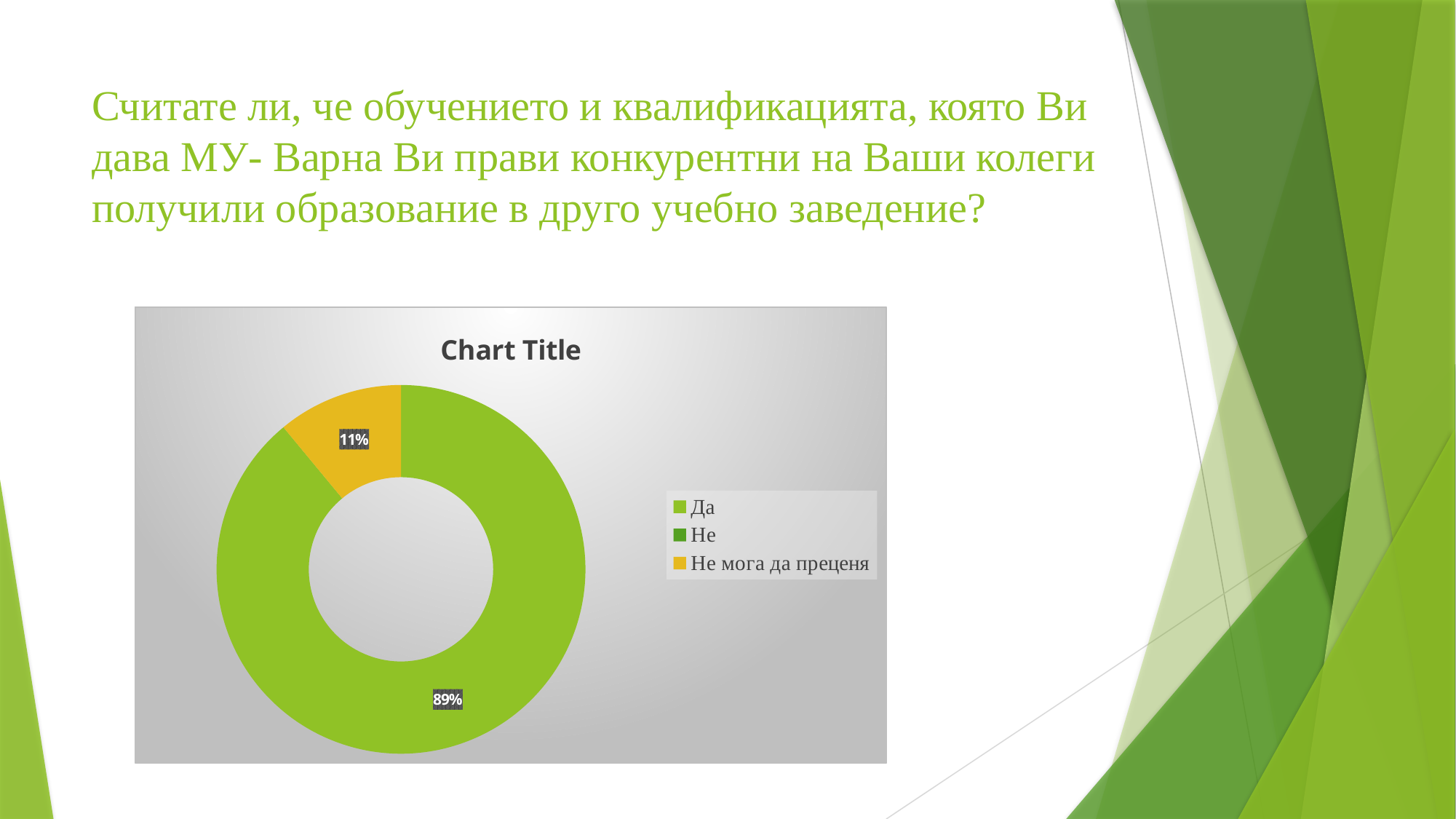
What is the title printed above the chart? Chart Title Which is larger, the share for "Да" or the share for "Не мога да преценя"? Да What colour is the slice for "Не мога да преценя"? Yellow What share of the doughnut does "Да" represent? 89% Which of the two labelled slices is smaller, "Да" or "Не мога да преценя"? Не мога да преценя What is the value shown for "Да"? 89% How many categories does the legend list? 3 What kind of chart is shown on the slide? Doughnut chart Which category has the largest share of the doughnut? Да What is the value shown for "Не мога да преценя"? 11% What is the difference between the shares for "Да" and "Не мога да преценя"? 78%